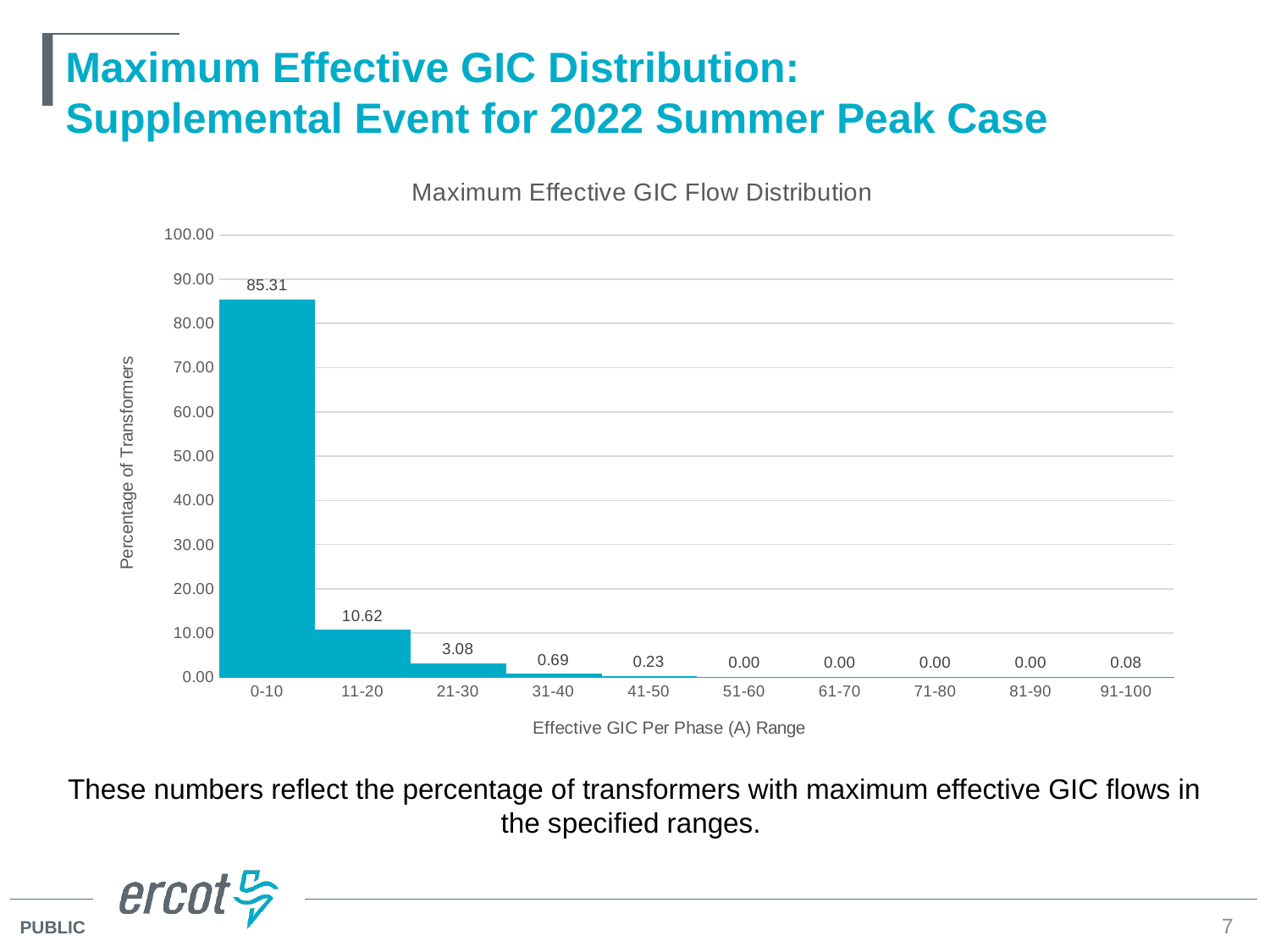
What is the value shown for the 21-30 range? 3.08 What is the percentage of transformers in the 11-20 range? 10.62 What is the difference between the values for the 0-10 and 11-20 ranges? 74.69 What kind of chart is shown on the slide? bar chart Which range has the highest percentage of transformers? 0-10 How many ranges are shown on the x axis? 10 Which is larger, the value for 21-30 or the value for 31-40? 21-30 Is the value for the 0-10 range greater or less than 80.00? greater What is the title of the chart? Maximum Effective GIC Flow Distribution What is the difference between the values for the 31-40 and 41-50 ranges? 0.46 What is the value shown for the 91-100 range? 0.08 What is the percentage of transformers in the 0-10 range? 85.31